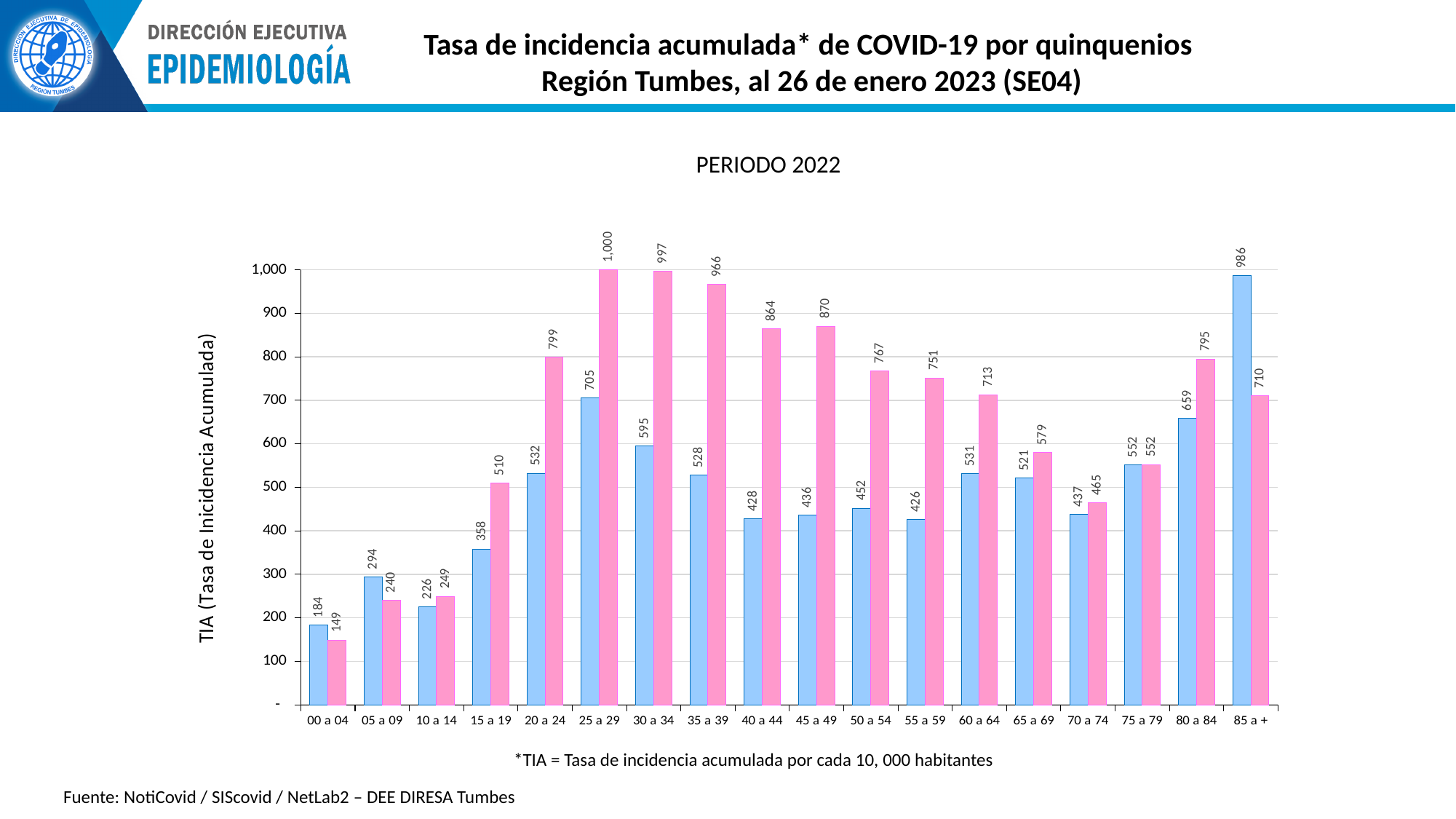
What is the value of the blue bar for the 25 a 29 age group? 705 What is the label of the y axis? TIA (Tasa de Incidencia Acumulada) What is the title shown above the chart? PERIODO 2022 What kind of chart is shown on the slide? bar chart What is the value of the pink bar for the 40 a 44 age group? 864 For the 85 a + age group, which bar is larger, the blue or the pink? blue Which age group has the lowest blue bar? 00 a 04 What is the difference between the pink bar and the blue bar for the 20 a 24 age group? 267 What is the value of the pink bar for the 75 a 79 age group? 552 Which age group has the highest pink bar? 25 a 29 How many age groups are shown on the x axis? 18 Is the value of the blue bar for the 80 a 84 age group greater or less than 600? greater